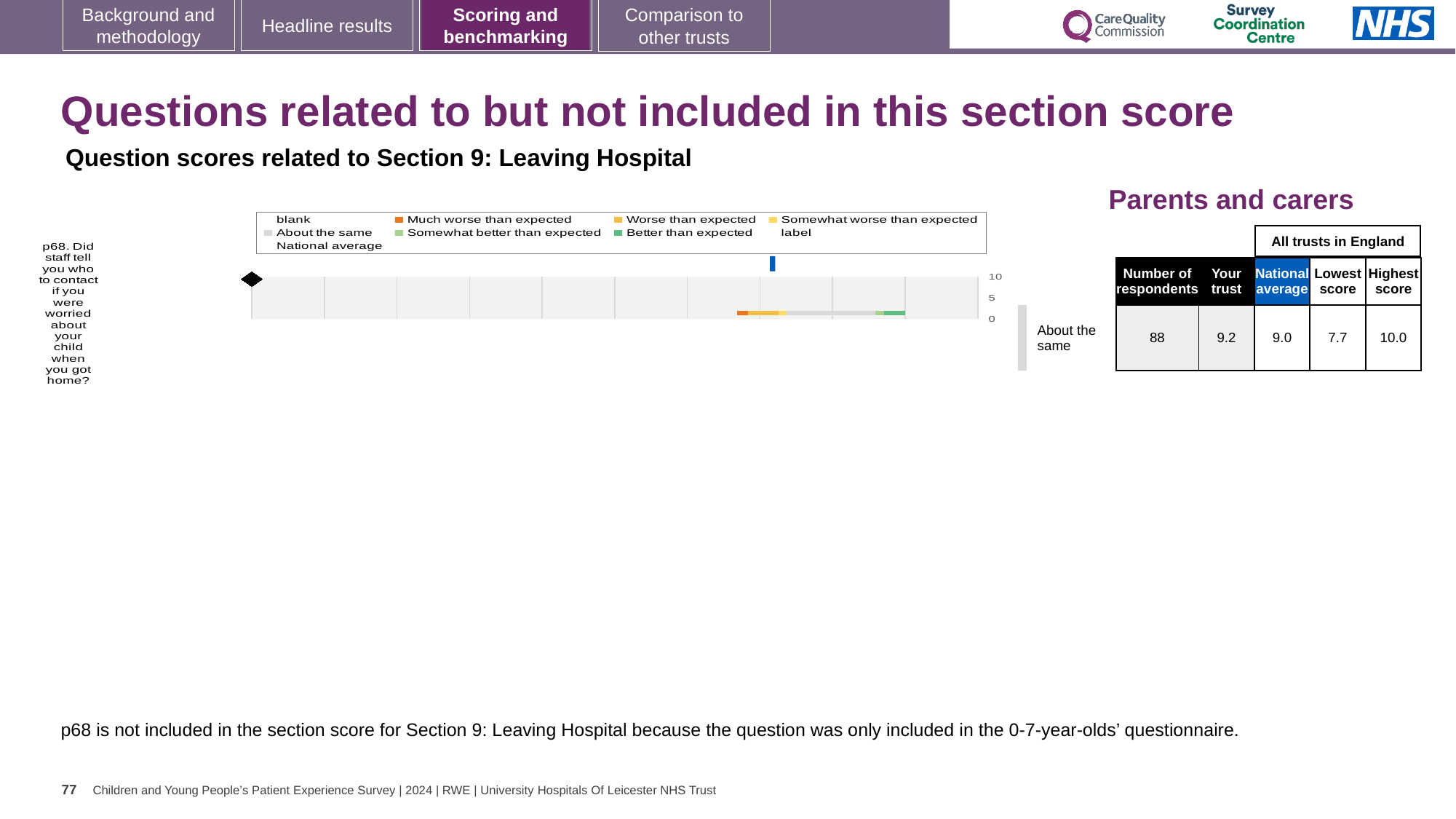
What is the 'Your trust' score for p68 shown in the table next to the chart? 9.2 Which is larger for p68, the 'Your trust' score or the national average? Your trust What is the difference between the highest score and the lowest score for p68? 2.3 What kind of chart is used to show the p68 question score? bar chart Which benchmark category label is shown to the right of the chart for p68? About the same What is the highest score among all trusts in England for p68? 10.0 Which question number is plotted in the chart? p68 What is the lowest score among all trusts in England for p68? 7.7 How many survey questions are plotted in the chart? 1 How many respondents answered p68 according to the table next to the chart? 88 What is the difference between the 'Your trust' score and the national average for p68? 0.2 What is the national average score for p68 shown in the table next to the chart? 9.0